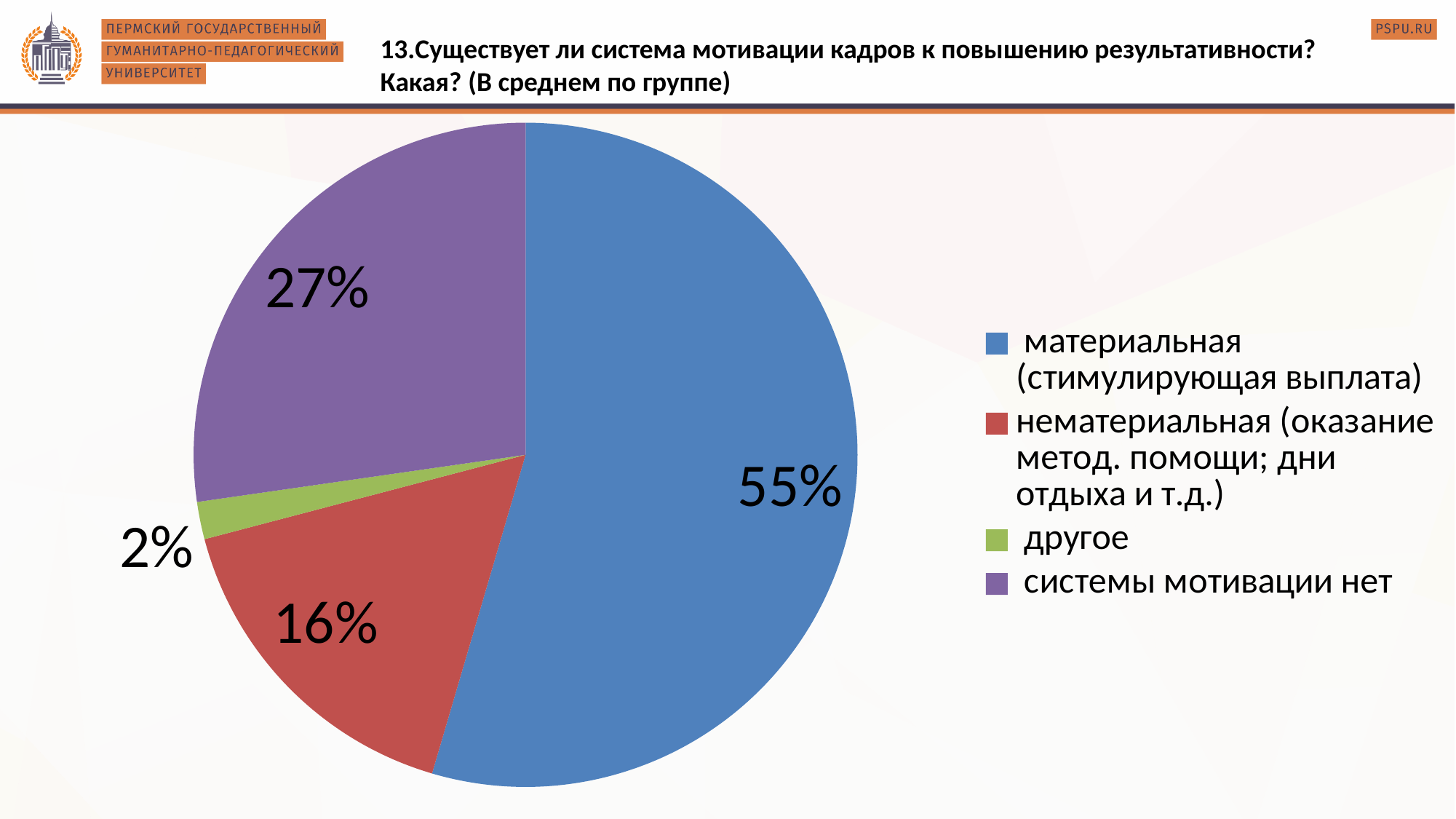
What colour is the slice for 'другое'? green What share of the pie does 'нематериальная (оказание метод. помощи; дни отдыха и т.д.)' have? 16% Which category has the smallest slice of the pie? другое What kind of chart is shown on the slide? pie chart What share of the pie does 'другое' have? 2% Which category has the largest slice of the pie? материальная (стимулирующая выплата) What is the difference in percentage points between 'материальная (стимулирующая выплата)' and 'системы мотивации нет'? 28 What share of the pie does 'системы мотивации нет' have? 27% How many entries does the legend list? 4 What share of the pie does 'материальная (стимулирующая выплата)' have? 55% Which is larger: the slice for 'нематериальная' or the slice for 'системы мотивации нет'? системы мотивации нет How many slices does the pie chart have? 4